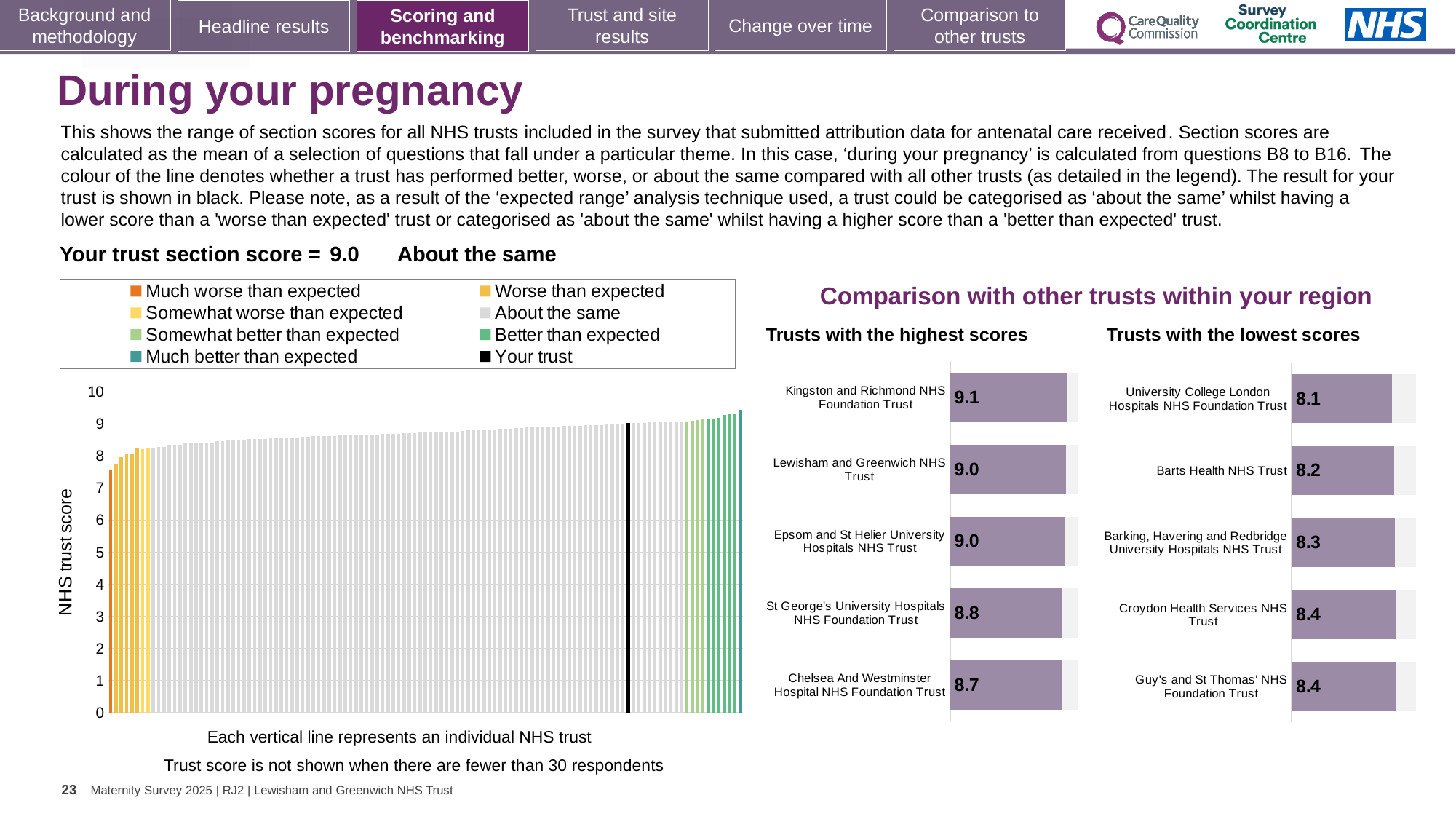
In the 'Trusts with the highest scores' chart, which trust has the highest score? Kingston and Richmond NHS Foundation Trust What kind of chart is the main 'NHS trust score' chart on the left? Bar chart What is the y-axis label of the main chart on the left? NHS trust score In the 'Trusts with the highest scores' chart, what is the score for Kingston and Richmond NHS Foundation Trust? 9.1 How many trusts are shown in the 'Trusts with the highest scores' chart? 5 In the 'Trusts with the lowest scores' chart, what is the score for Barking, Havering and Redbridge University Hospitals NHS Trust? 8.3 In the 'Trusts with the lowest scores' chart, which trust has the lowest score? University College London Hospitals NHS Foundation Trust In the 'Trusts with the highest scores' chart, what is the score for Chelsea And Westminster Hospital NHS Foundation Trust? 8.7 How many entries does the legend of the main 'NHS trust score' chart list? 8 In the main 'NHS trust score' chart, do the values rise or fall from left to right? Rise In the 'Trusts with the highest scores' chart, what is the difference between the scores of Kingston and Richmond NHS Foundation Trust and Chelsea And Westminster Hospital NHS Foundation Trust? 0.4 In the 'Trusts with the lowest scores' chart, which has the higher score: Barts Health NHS Trust or Croydon Health Services NHS Trust? Croydon Health Services NHS Trust